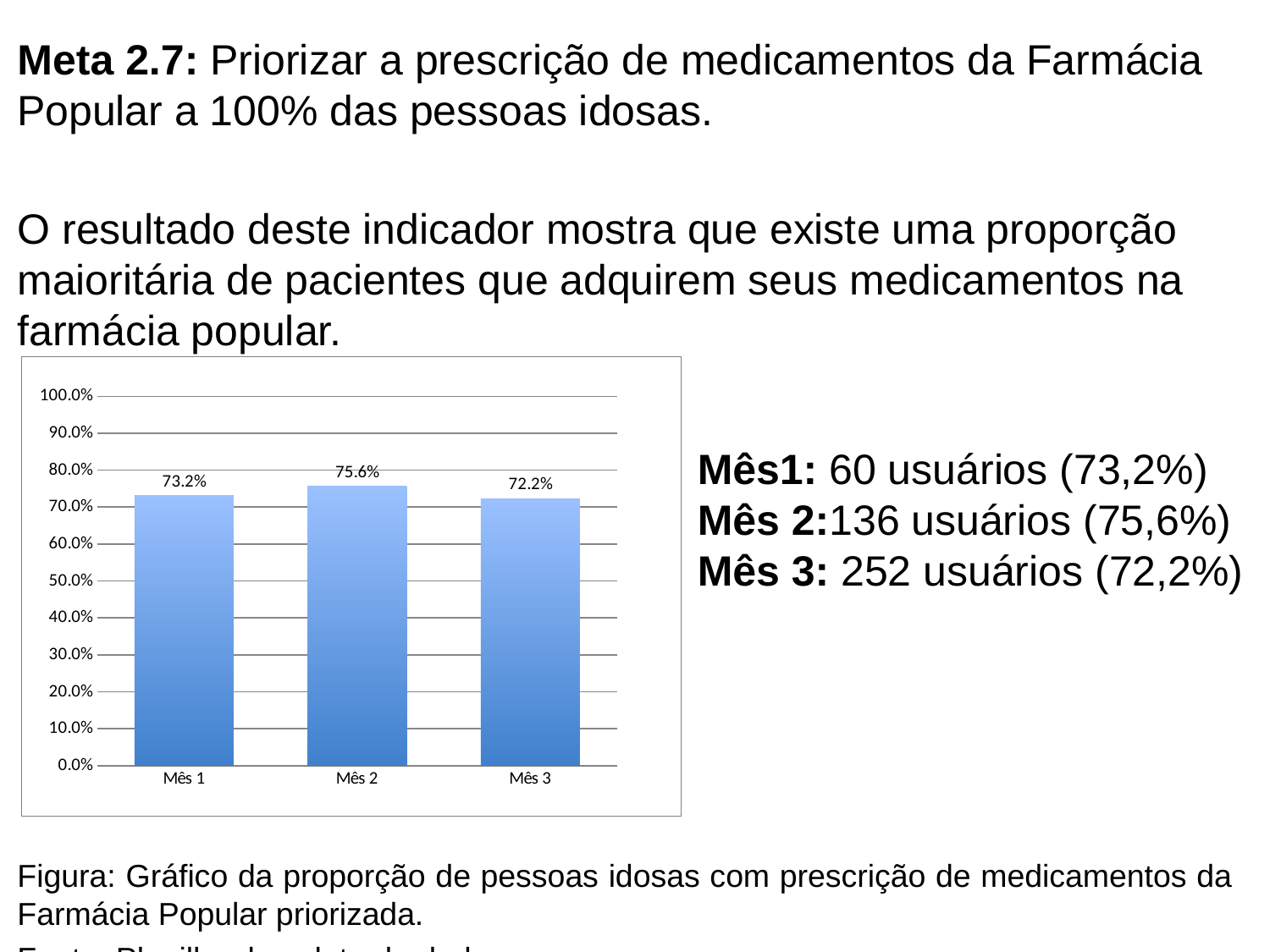
What is the value for Mês 1? 73.2% Which month has the highest value? Mês 2 Which month has the lowest value? Mês 3 What is the value for Mês 3? 72.2% How many categories are shown on the x axis? 3 What is the highest value shown on the y axis? 100.0% What is the difference between the values for Mês 1 and Mês 3? 1.0% What is the value for Mês 2? 75.6% What is the difference between the values for Mês 2 and Mês 3? 3.4% Which is larger, the value for Mês 1 or the value for Mês 2? Mês 2 What kind of chart is shown on the slide? bar chart Is the value for Mês 2 greater or less than 80.0%? less